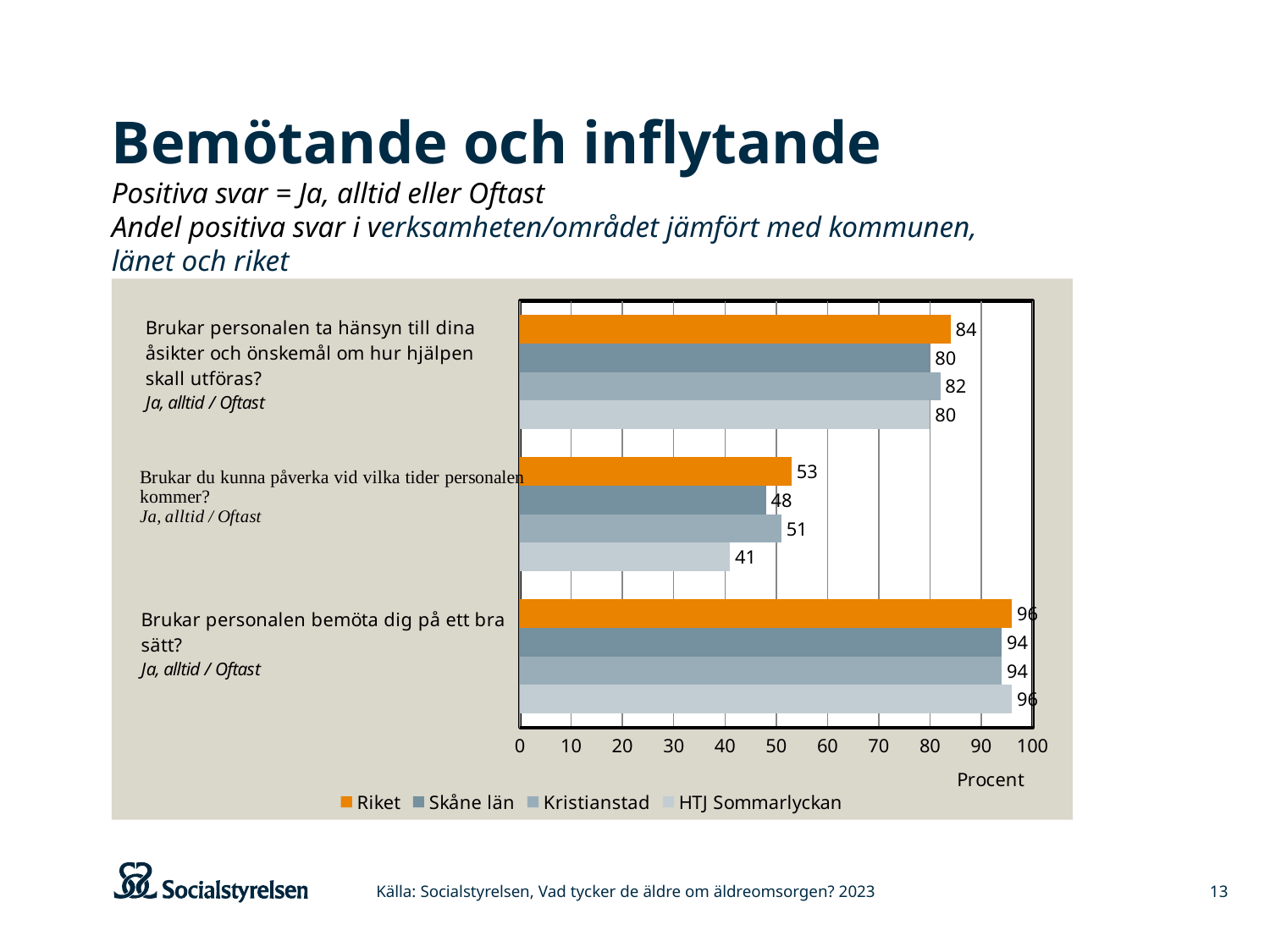
What is the value for HTJ Sommarlyckan on the question "Brukar du kunna påverka vid vilka tider personalen kommer?"? 41 Which is larger on the question "Brukar personalen ta hänsyn till dina åsikter och önskemål om hur hjälpen skall utföras?": Kristianstad or Skåne län? Kristianstad What is the value for Riket on the question "Brukar personalen ta hänsyn till dina åsikter och önskemål om hur hjälpen skall utföras?"? 84 Which series has the highest value on the question "Brukar personalen ta hänsyn till dina åsikter och önskemål om hur hjälpen skall utföras?"? Riket How many series does the legend list? 4 What kind of chart is shown on the slide? Bar chart What is the value for Kristianstad on the question "Brukar personalen bemöta dig på ett bra sätt?"? 94 Which series has the lowest value on the question "Brukar du kunna påverka vid vilka tider personalen kommer?"? HTJ Sommarlyckan What is the difference between Riket and HTJ Sommarlyckan on the question "Brukar du kunna påverka vid vilka tider personalen kommer?"? 12 What unit label is shown on the horizontal axis of the chart? Procent Is the value for HTJ Sommarlyckan on the question "Brukar du kunna påverka vid vilka tider personalen kommer?" greater or less than 50? less What is the value for Skåne län on the question "Brukar du kunna påverka vid vilka tider personalen kommer?"? 48